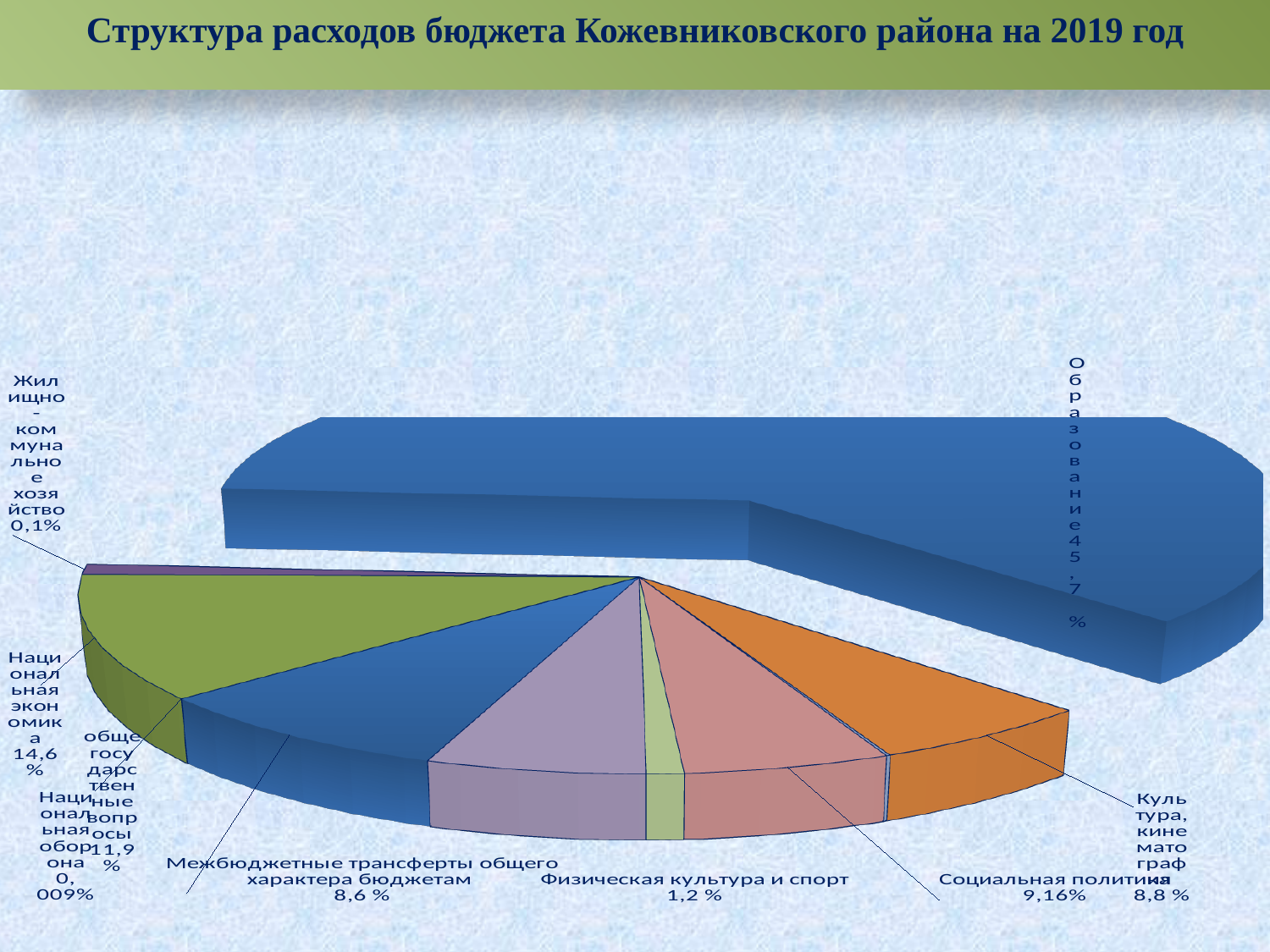
What share of the budget expenditure goes to Образование? 45,7 % What kind of chart is shown on the slide? Pie chart What is the difference between the shares of Национальная экономика and Общегосударственные вопросы? 2,7 % Which category has the smallest share of the pie? Национальная оборона What is the value shown for Межбюджетные трансферты общего характера бюджетам? 8,6 % What is the value shown for Национальная экономика? 14,6 % Which is larger: Социальная политика or Культура, кинематография? Социальная политика What is the value shown for Социальная политика? 9,16% What is the title of the chart? Структура расходов бюджета Кожевниковского района на 2019 год Which category has the largest share of the pie? Образование What is the value shown for Физическая культура и спорт? 1,2 %